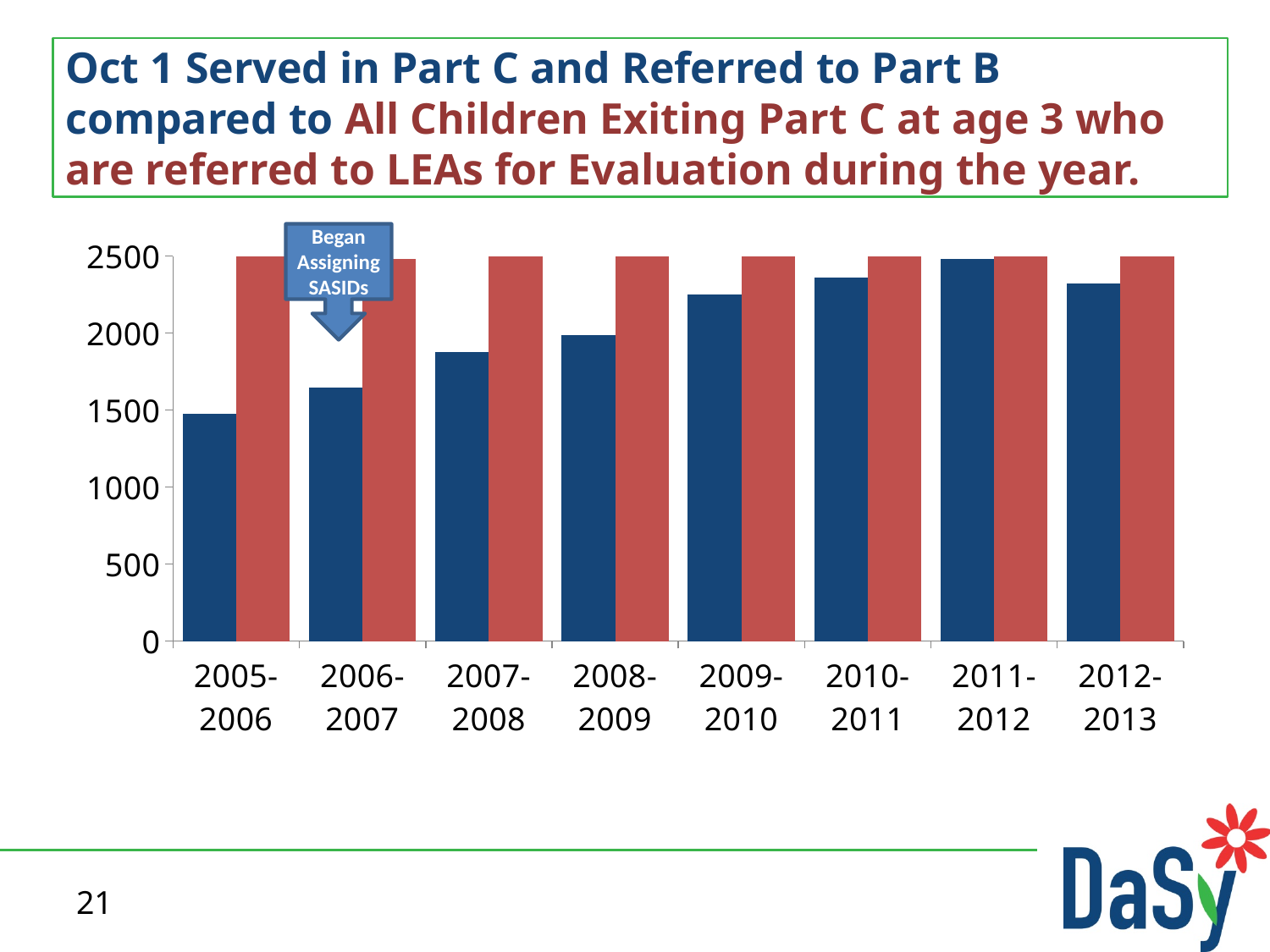
What kind of chart is shown on the slide? bar chart Which school year has the highest blue bar (Oct 1 Served in Part C and Referred to Part B)? 2011-2012 Is the blue bar for 2005-2006 greater or less than 2000? less Do the blue bars generally rise or fall from 2005-2006 to 2011-2012? rise What does the callout arrow above the 2006-2007 bars say? Began Assigning SASIDs Is the blue bar for 2007-2008 greater or less than 2000? less Is the blue bar for 2009-2010 greater or less than 2000? greater How many school-year categories are shown on the x axis? 8 In 2005-2006, which bar is taller, the blue bar or the red bar? the red bar Which school year has the lowest blue bar (Oct 1 Served in Part C and Referred to Part B)? 2005-2006 Which is larger, the blue bar for 2010-2011 or the blue bar for 2008-2009? 2010-2011